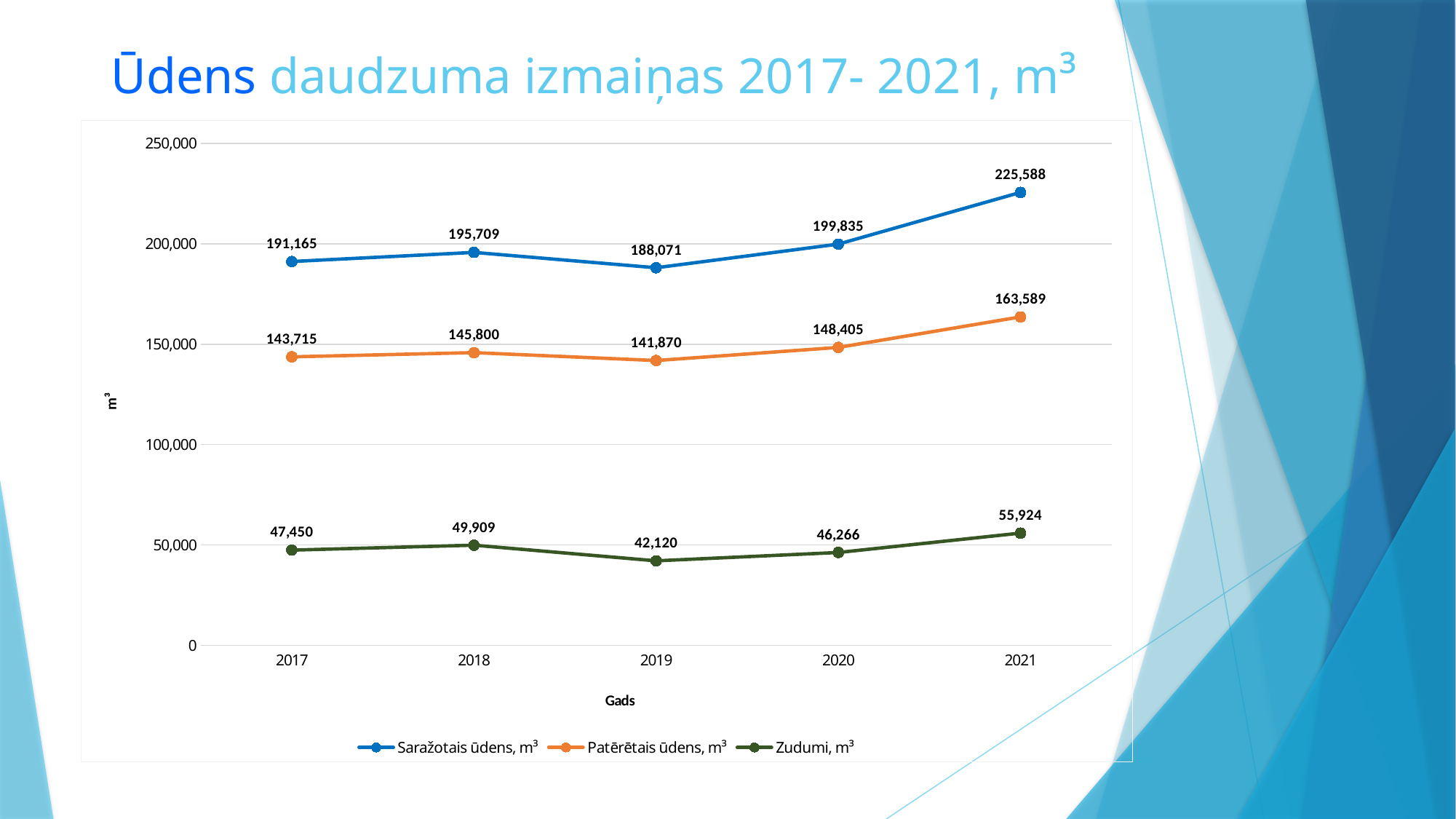
What is the value of Zudumi, m³ in 2018? 49,909 Is the value of Saražotais ūdens, m³ in 2020 greater or less than 200,000? less What is the value of Saražotais ūdens, m³ in 2021? 225,588 What is the value of Patērētais ūdens, m³ in 2019? 141,870 What kind of chart is shown on the slide? line chart How many series does the legend list? 3 How many years are shown on the x axis? 5 Which is larger: Patērētais ūdens, m³ in 2018 or in 2020? 2020 What is the difference between Saražotais ūdens, m³ and Patērētais ūdens, m³ in 2021? 61,999 By how much did Zudumi, m³ increase from 2019 to 2021? 13,804 In which year is Saražotais ūdens, m³ the lowest? 2019 In which year is Zudumi, m³ the highest? 2021